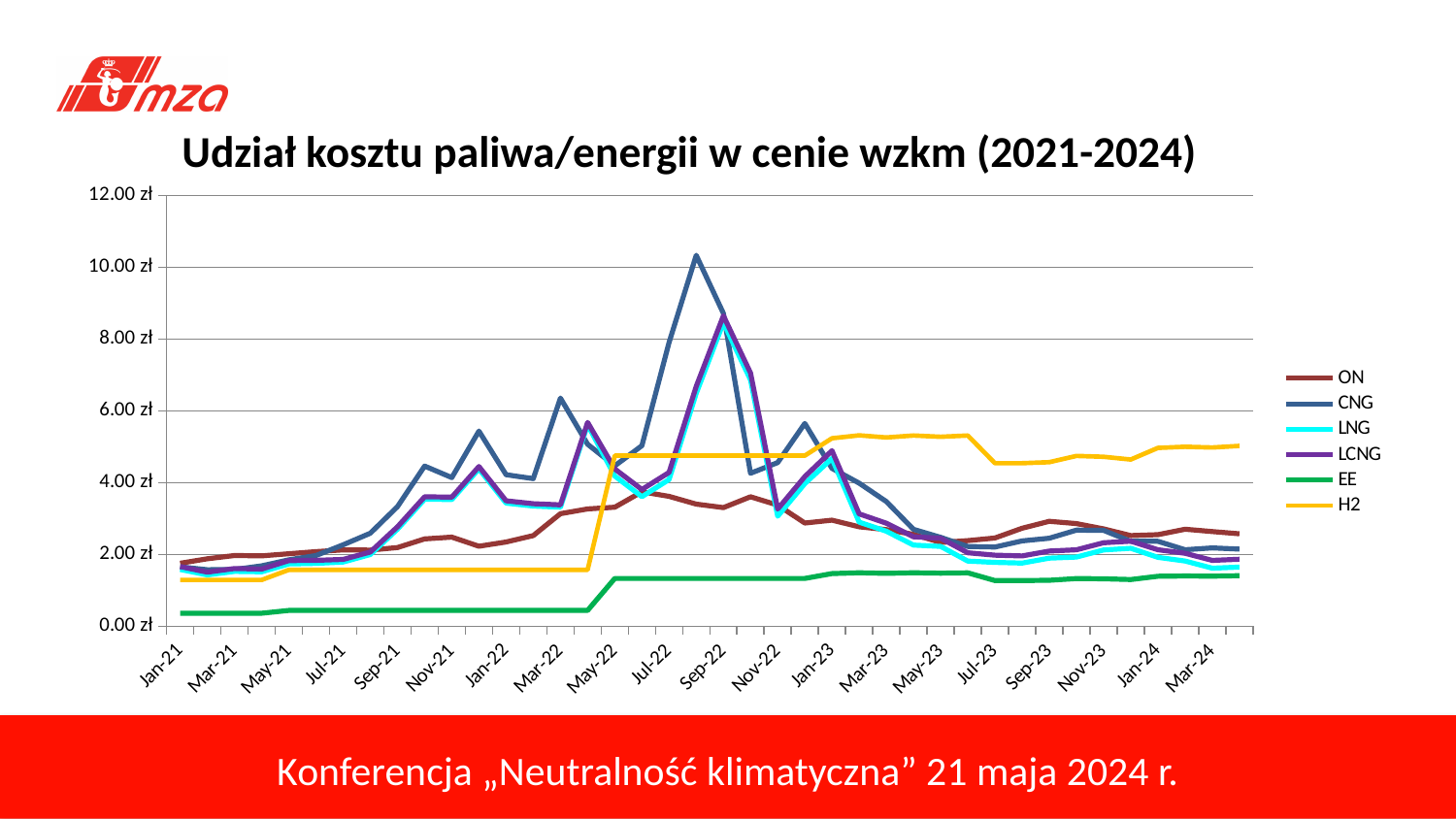
Which series reaches the highest value anywhere on the chart? CNG Does the H2 line rise or fall overall from Jan-21 to Mar-24? rise What kind of chart is shown on the slide? line chart Is the value for CNG in Sep-22 greater or less than 8.00 zł? greater Which series has the lowest values across the whole period? EE How many series does the legend list? 6 Which series is drawn with a green line? EE What is the title of the chart? Udział kosztu paliwa/energii w cenie wzkm (2021-2024) Is the value for H2 in Mar-23 greater or less than 4.00 zł? greater In Jan-21, which is larger, H2 or EE? H2 Is the value for EE in Jan-21 greater or less than 1.00 zł? less In Sep-22, which is larger, CNG or ON? CNG